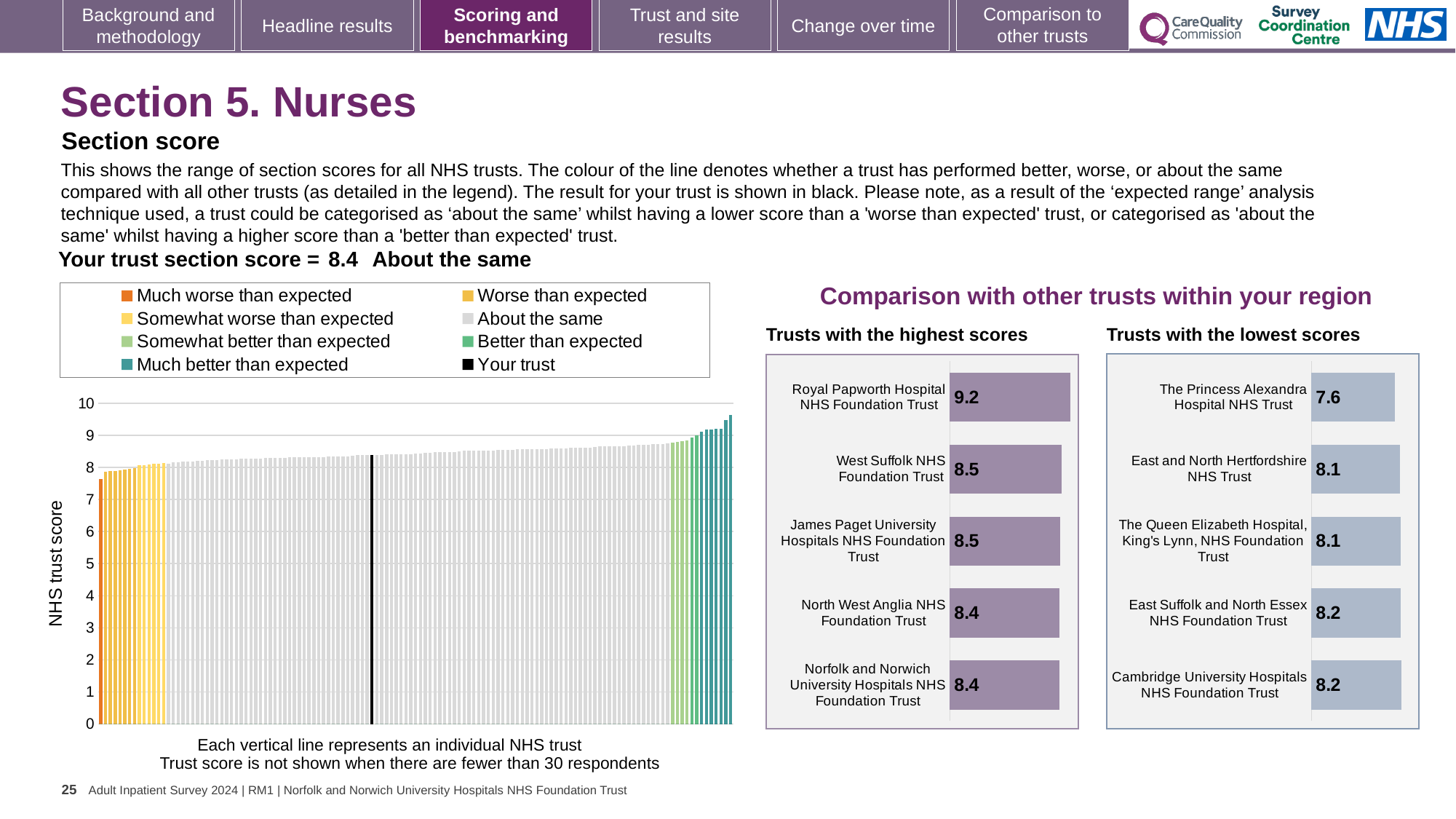
In the 'Trusts with the highest scores' chart, what is the score for Royal Papworth Hospital NHS Foundation Trust? 9.2 How many entries does the legend of the main NHS trust score chart on the left list? 8 How many trusts are shown in the 'Trusts with the lowest scores' chart? 5 In the 'Trusts with the highest scores' chart, which has the larger score: Royal Papworth Hospital NHS Foundation Trust or West Suffolk NHS Foundation Trust? Royal Papworth Hospital NHS Foundation Trust In the 'Trusts with the highest scores' chart, what is the difference between the scores of Royal Papworth Hospital NHS Foundation Trust and Norfolk and Norwich University Hospitals NHS Foundation Trust? 0.8 In the 'Trusts with the lowest scores' chart, which trust has the lowest score? The Princess Alexandra Hospital NHS Trust In the main NHS trust score chart on the left, is the value for your trust (the black line) greater or less than 8? greater In the main NHS trust score chart on the left, what is the section score for your trust (the black line)? 8.4 In the 'Trusts with the lowest scores' chart, what is the difference between the scores of Cambridge University Hospitals NHS Foundation Trust and The Princess Alexandra Hospital NHS Trust? 0.6 In the 'Trusts with the lowest scores' chart, what is the score for The Princess Alexandra Hospital NHS Trust? 7.6 In the 'Trusts with the highest scores' chart, which trust has the highest score? Royal Papworth Hospital NHS Foundation Trust In the main NHS trust score chart on the left, do the trust scores rise or fall from left to right? rise